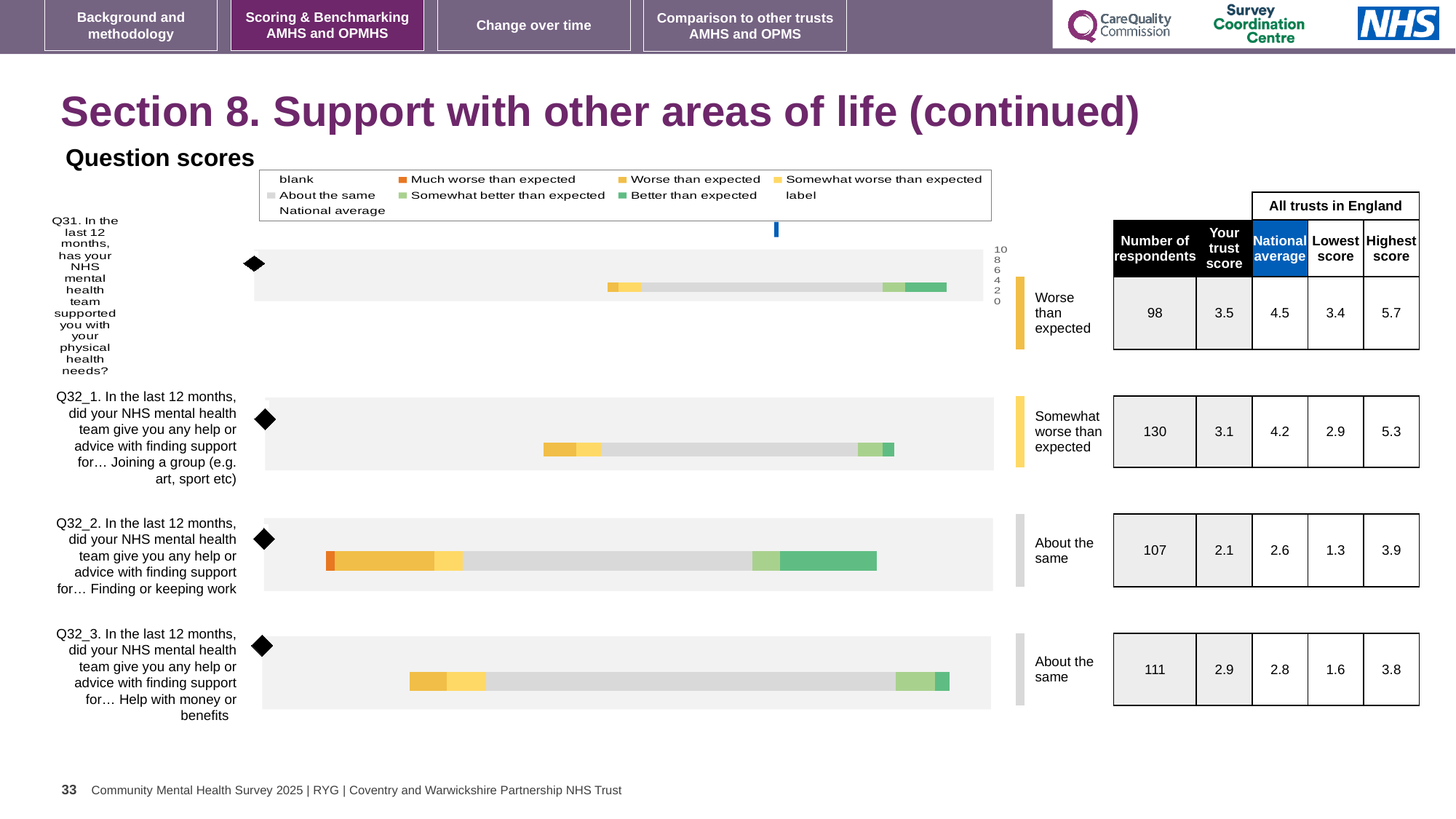
How many respondents are listed for Q32_2 (finding or keeping work)? 107 What rating label is shown next to the bar for Q31 (support with physical health needs)? Worse than expected What is 'Your trust score' for Q31? 3.5 How many question bars are plotted on the slide? 4 What kind of chart is used to show the question scores on this slide? bar chart How many rating categories from 'Much worse than expected' to 'Better than expected' does the legend list? 6 What is the difference between the national average and 'Your trust score' for Q31? 1.0 What colour represents 'Better than expected' in the legend? green What rating label is shown next to the bar for Q32_2 (help with finding or keeping work)? About the same Which question has the lowest 'Your trust score'? Q32_2 What rating label is shown next to the bar for Q32_1 (help with joining a group)? Somewhat worse than expected For Q32_3 (help with money or benefits), which is larger: 'Your trust score' or the national average? Your trust score